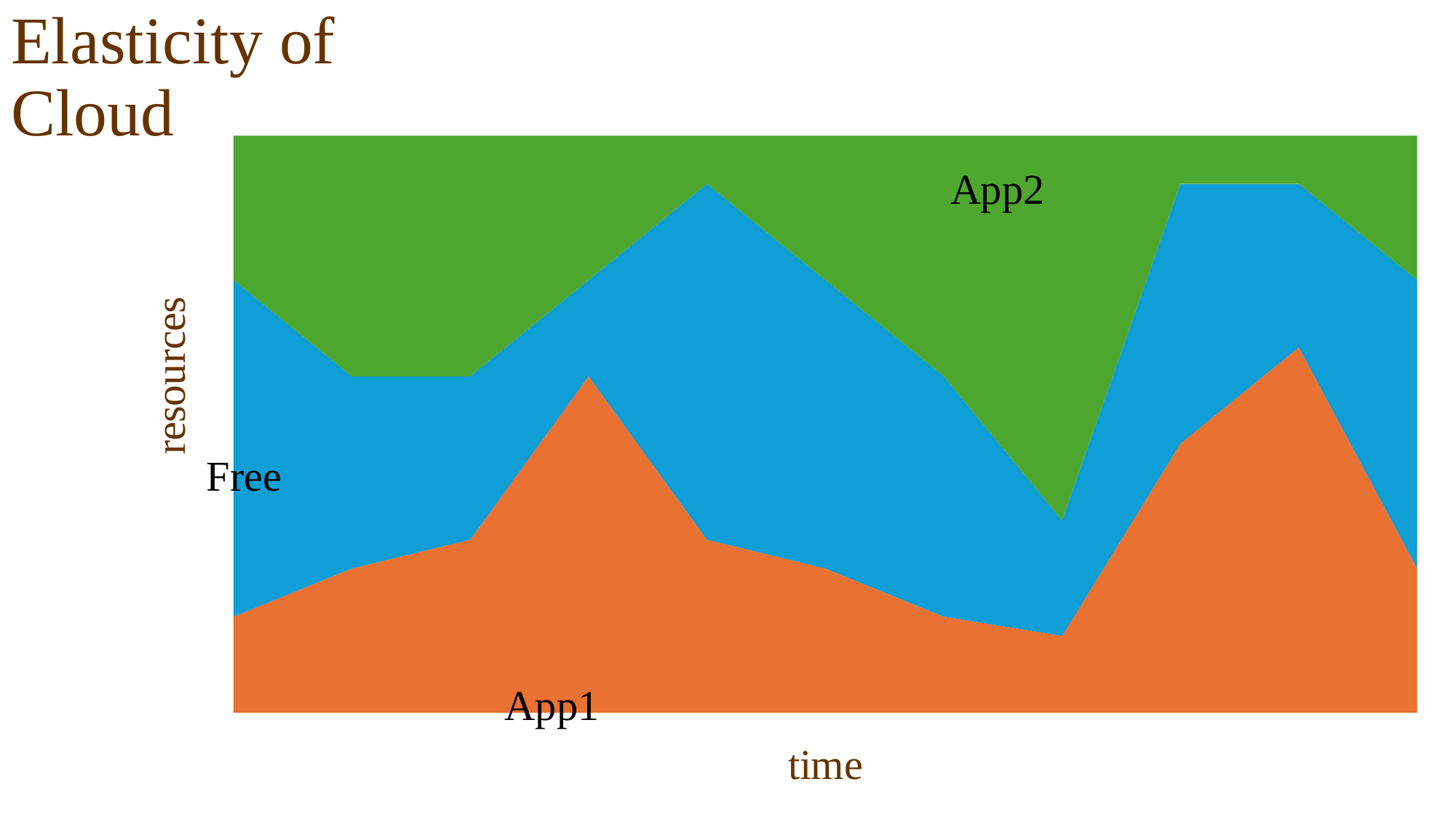
Which region is shown in orange at the bottom of the chart? App1 Which region is shown in green at the top of the chart? App2 What label is on the horizontal axis of the chart? time What label is on the vertical axis of the chart? resources What kind of chart is shown on the slide? Stacked area chart What is the title of the slide containing the chart? Elasticity of Cloud Which region is shown in blue between App1 and App2? Free Which region lies directly above App1 in the stack? Free How many labelled regions (series) does the chart show? 3